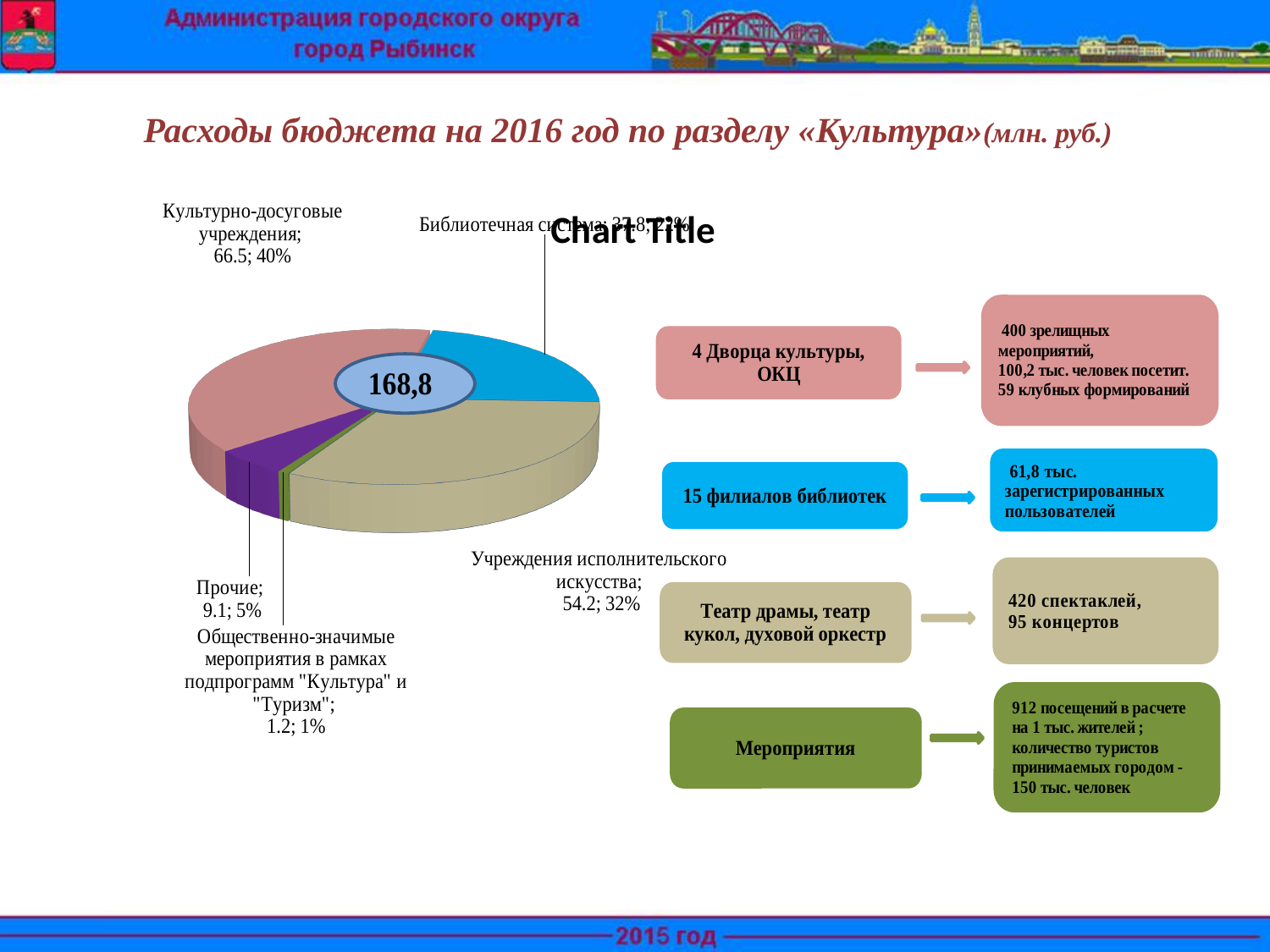
What is the difference between the values for Культурно-досуговые учреждения and Учреждения исполнительского искусства? 12.3 What is the value for Прочие in the pie chart? 9.1 What is the value for Культурно-досуговые учреждения in the pie chart? 66.5 What share of the pie does Прочие represent? 5% What is the value for Учреждения исполнительского искусства in the pie chart? 54.2 Which category has the largest slice of the pie chart? Культурно-досуговые учреждения What type of chart is shown on the slide? pie chart What total value is shown in the centre of the pie chart? 168,8 What share of the pie does Культурно-досуговые учреждения represent? 40% Which category has the smallest slice of the pie chart? Общественно-значимые мероприятия в рамках подпрограмм "Культура" и "Туризм" What share of the pie does Учреждения исполнительского искусства represent? 32% What is the value for Общественно-значимые мероприятия в рамках подпрограмм "Культура" и "Туризм"? 1.2